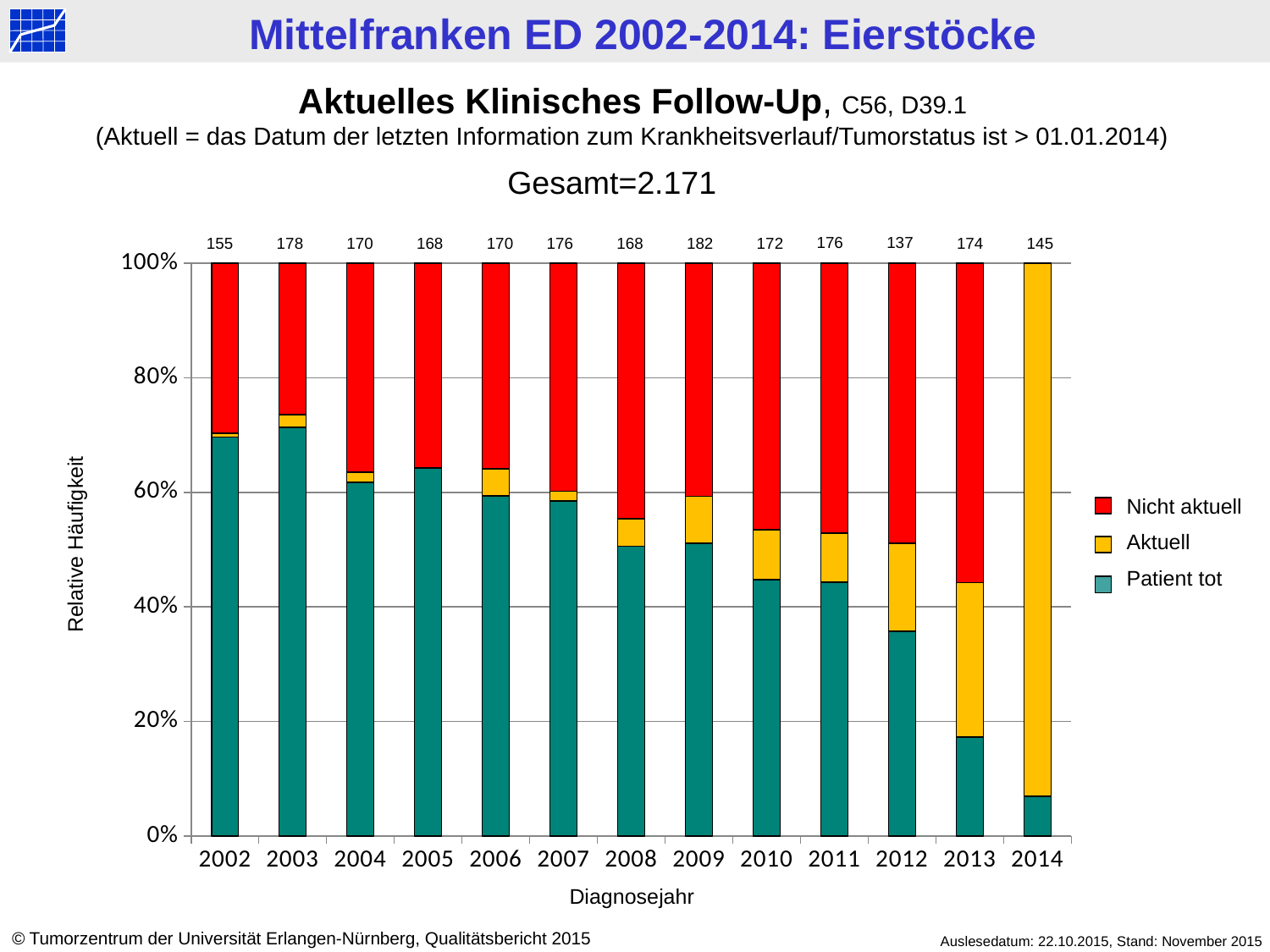
Which year has the larger number printed above its bar, 2002 or 2003? 2003 Is the 'Patient tot' share for 2013 greater or less than 20%? less Which diagnosis year has the lowest number printed above its bar? 2012 What is the difference between the numbers printed above the bars for 2009 and 2012? 45 What number is printed above the bar for 2012? 137 What number is printed above the bar for 2002? 155 Which diagnosis year has the highest number printed above its bar? 2009 What kind of chart is shown on the slide? Stacked bar chart Is the 'Patient tot' share for 2002 greater or less than 60%? greater How many series does the legend list? 3 How many diagnosis years are shown on the x axis? 13 What number is printed above the bar for 2009? 182